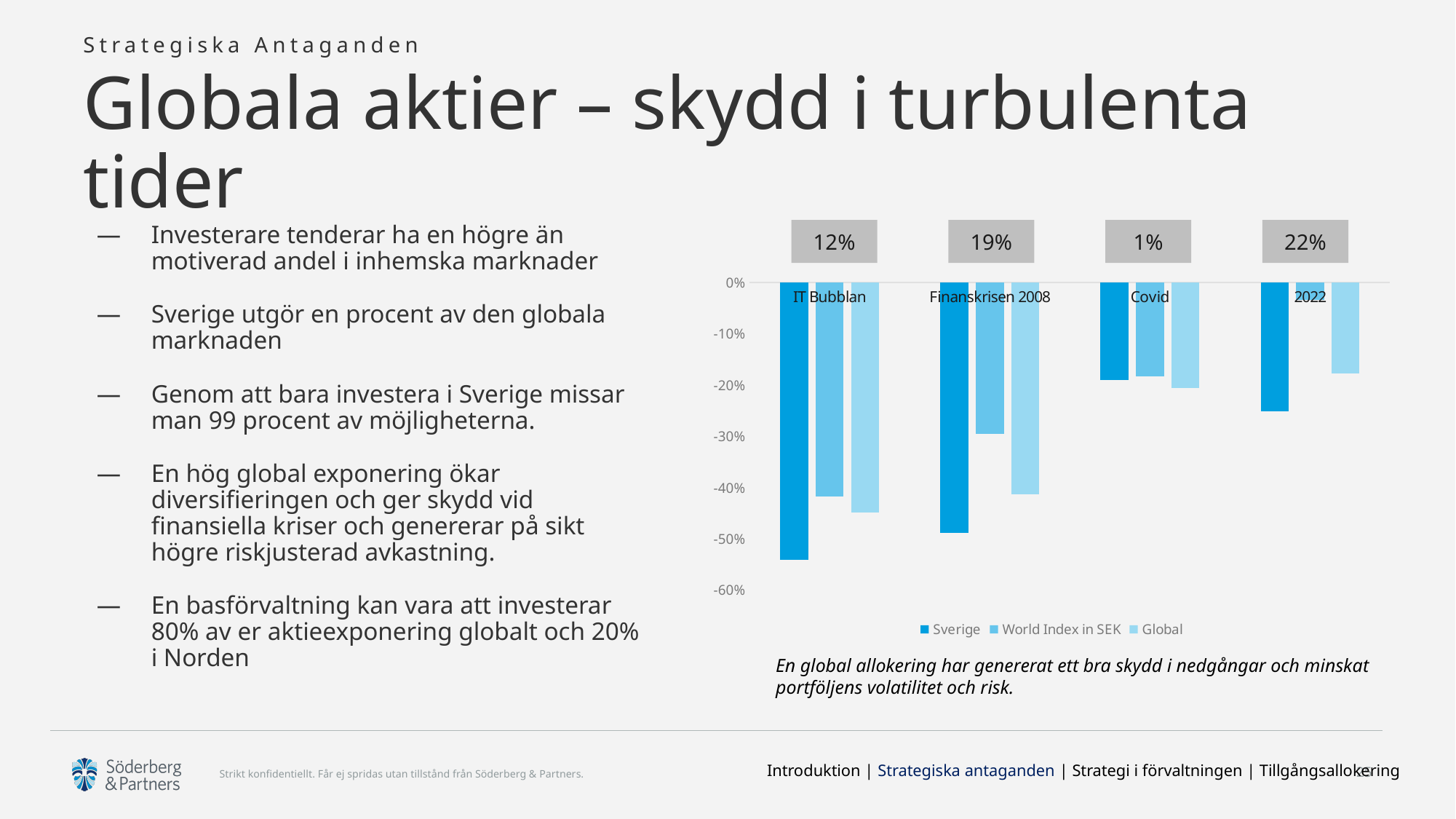
How many series does the chart legend list? 3 What percentage is shown in the grey box above the Finanskrisen 2008 category? 19% What percentage is shown in the grey box above the 2022 category? 22% How many categories (crisis periods) are shown on the x axis of the chart? 4 Is the Sverige value for IT Bubblan greater or less than -50%? less In the 2022 category, which is lower: the Sverige value or the Global value? Sverige In the Finanskrisen 2008 category, which series has the most negative value? Sverige Is the World Index in SEK value for 2022 greater or less than -10%? greater What kind of chart is shown on the slide? bar chart What percentage is shown in the grey box above the Covid category? 1% What are the three series listed in the chart legend? Sverige, World Index in SEK, Global Which category has the lowest (most negative) value for the Sverige series? IT Bubblan